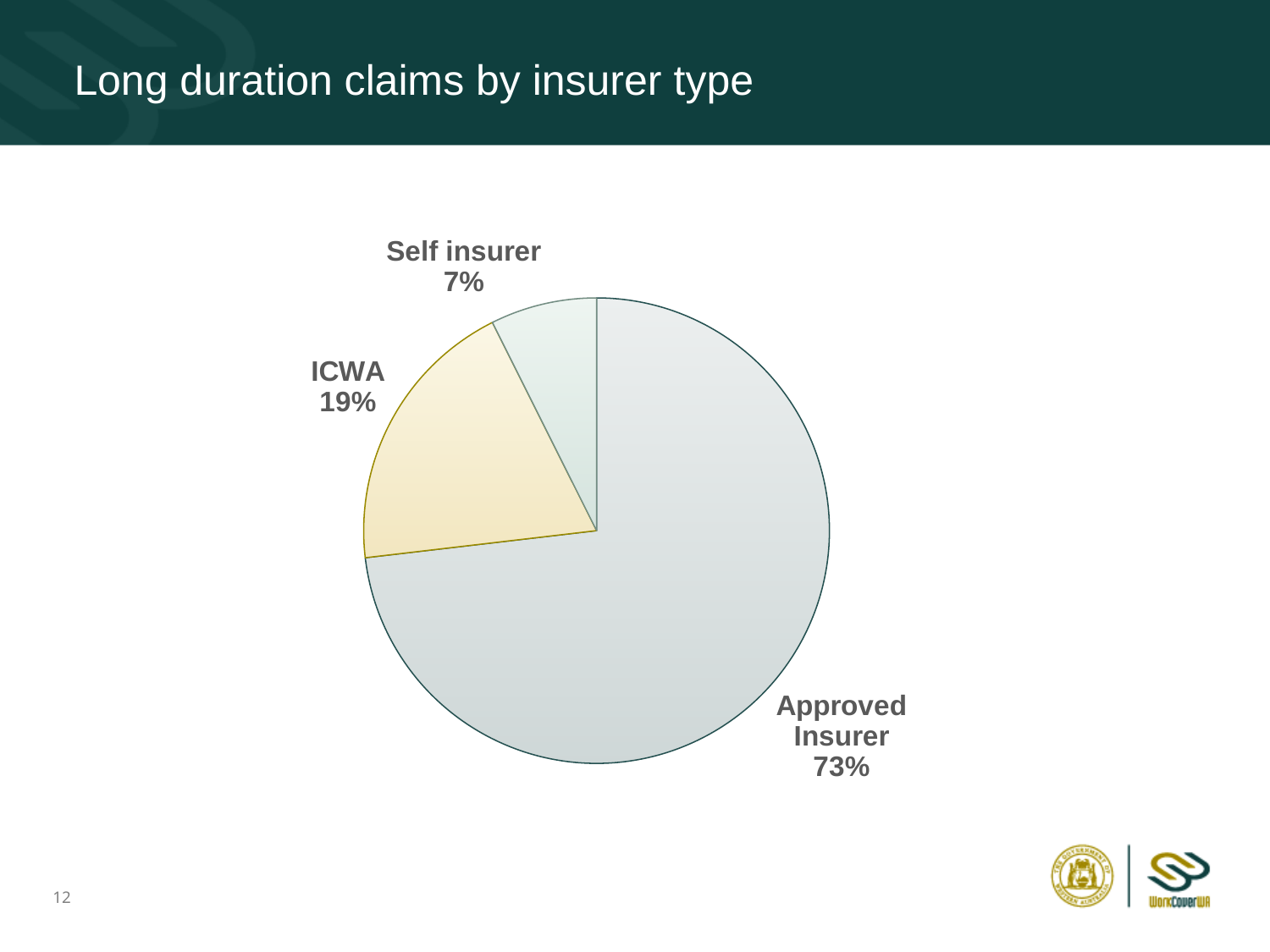
Which has a larger share of long duration claims, ICWA or Self insurer? ICWA What share of long duration claims is attributed to Approved Insurer? 73% What kind of chart is shown on the slide? pie chart What share of long duration claims is attributed to Self insurer? 7% What is the title of the slide containing the pie chart? Long duration claims by insurer type Which slice of the pie chart is coloured yellow? ICWA Which insurer type has the smallest share of long duration claims? Self insurer Which insurer type has the largest share of long duration claims? Approved Insurer What is the difference in percentage points between the Approved Insurer share and the ICWA share? 54 What is the difference in percentage points between the ICWA share and the Self insurer share? 12 What share of long duration claims is attributed to ICWA? 19% How many insurer types are shown in the pie chart? 3